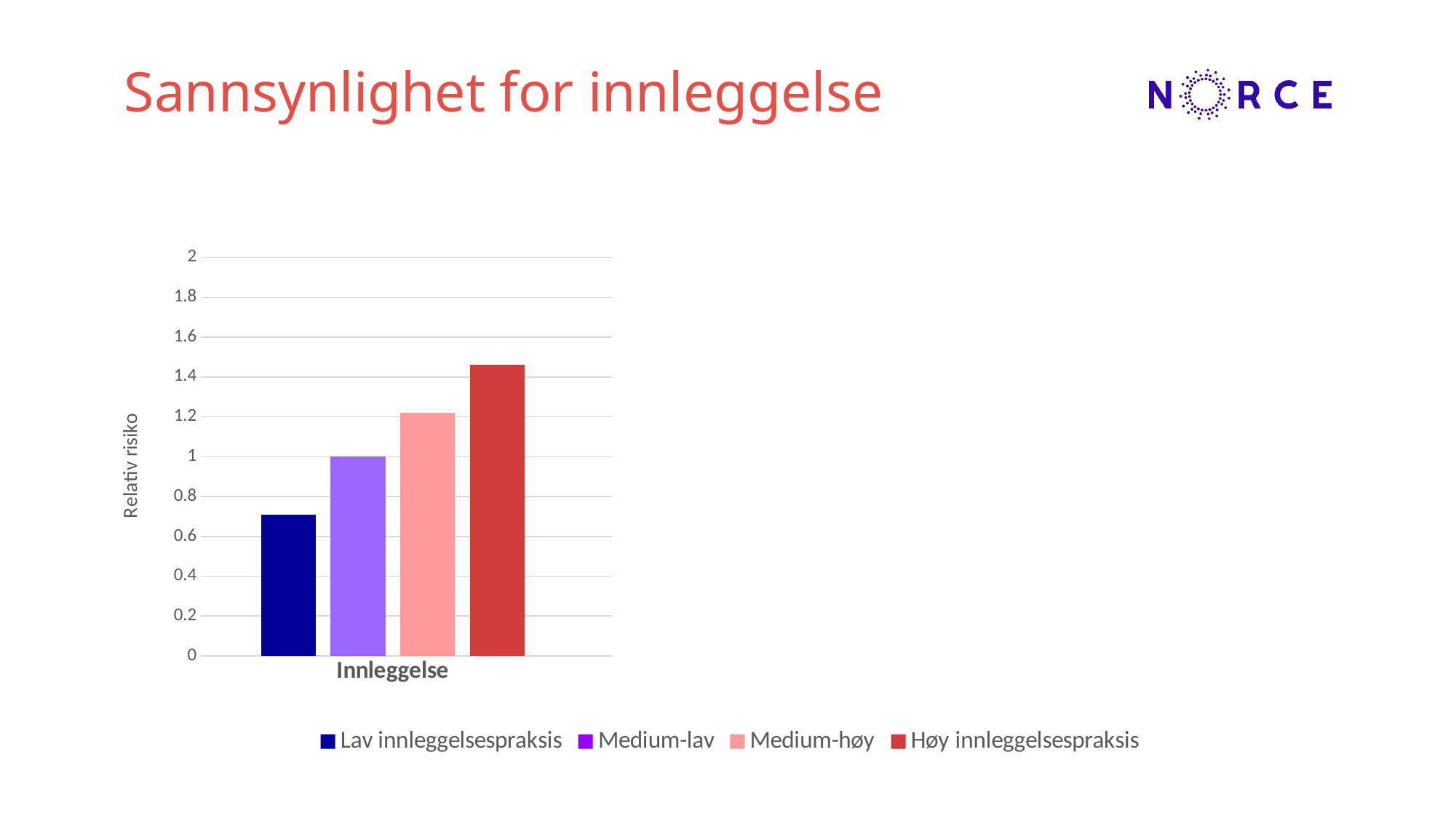
Is the value for Høy innleggelsespraksis greater or less than 1.4? greater Is the value for Lav innleggelsespraksis greater or less than 0.8? less What is the label on the y axis? Relativ risiko Which is larger, the value for Medium-høy or the value for Medium-lav? Medium-høy How many categories are shown on the x axis? 1 Is the value for Medium-høy greater or less than 1.4? less What kind of chart is shown on the slide? bar chart How many series does the legend list? 4 Which series has the lowest relative risk for Innleggelse? Lav innleggelsespraksis What is the title of the slide? Sannsynlighet for innleggelse Which series has the highest relative risk for Innleggelse? Høy innleggelsespraksis What is the relative risk for Medium-lav? 1